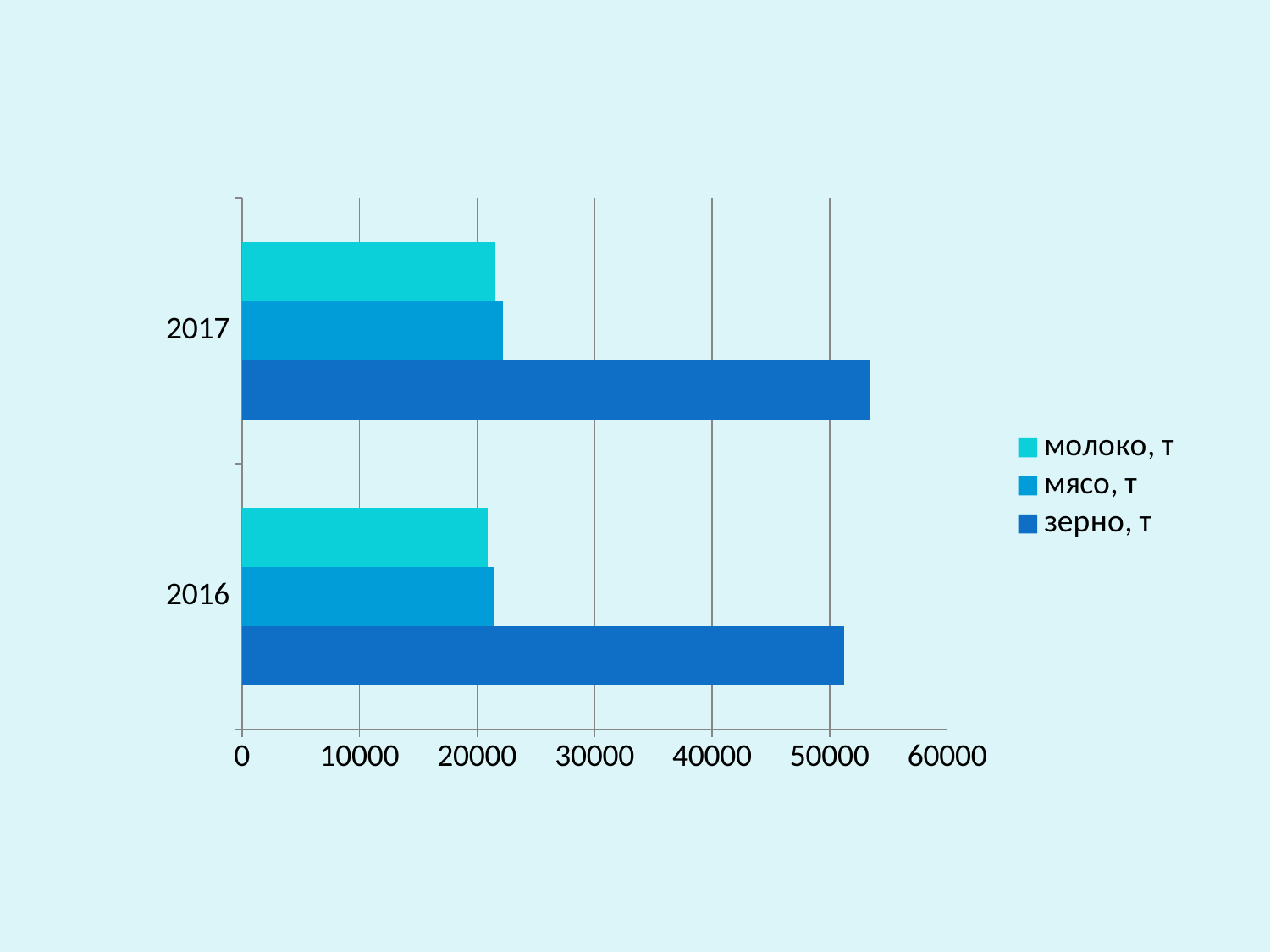
Which series has the highest value for 2017? зерно, т Which is larger in 2016: зерно, т or молоко, т? зерно, т How many series does the legend list? 3 Which is larger: зерно, т in 2017 or зерно, т in 2016? зерно, т in 2017 What kind of chart is shown on the slide? bar chart How many years (categories) are shown on the chart? 2 What is the maximum value shown on the horizontal axis? 60000 Is the value for молоко, т in 2017 greater or less than 20000? greater Is the value for мясо, т in 2016 greater or less than 30000? less Is the value for зерно, т in 2017 greater or less than 60000? less Which series has the highest value for 2016? зерно, т